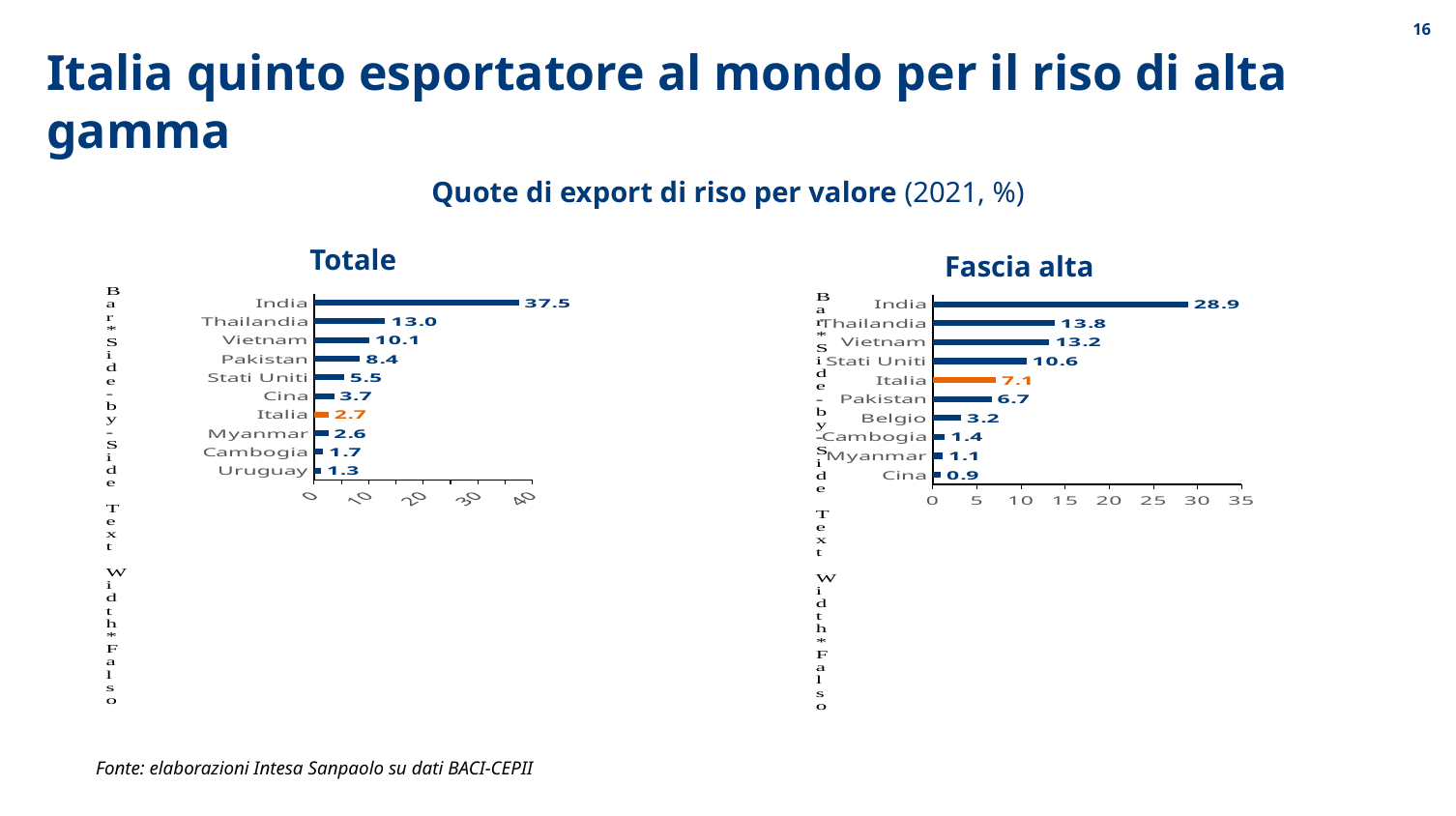
In the 'Fascia alta' chart, is the value for Stati Uniti greater or less than 10? greater In the 'Fascia alta' chart, what is the value for Cina? 0.9 In the 'Totale' chart, what is the value for India? 37.5 In the 'Totale' chart, which country has the lowest value? Uruguay What kind of chart is the 'Fascia alta' chart? Bar chart In the 'Fascia alta' chart, what is the difference between the values for Thailandia and Vietnam? 0.6 In the 'Totale' chart, which country's bar is highlighted in orange? Italia In the 'Totale' chart, which is larger, the value for Pakistan or the value for Stati Uniti? Pakistan In the 'Totale' chart, what is the difference between the values for India and Thailandia? 24.5 In the 'Fascia alta' chart, which country has the highest value? India In the 'Fascia alta' chart, what is the value for Italia? 7.1 How many countries are shown in the 'Totale' chart? 10